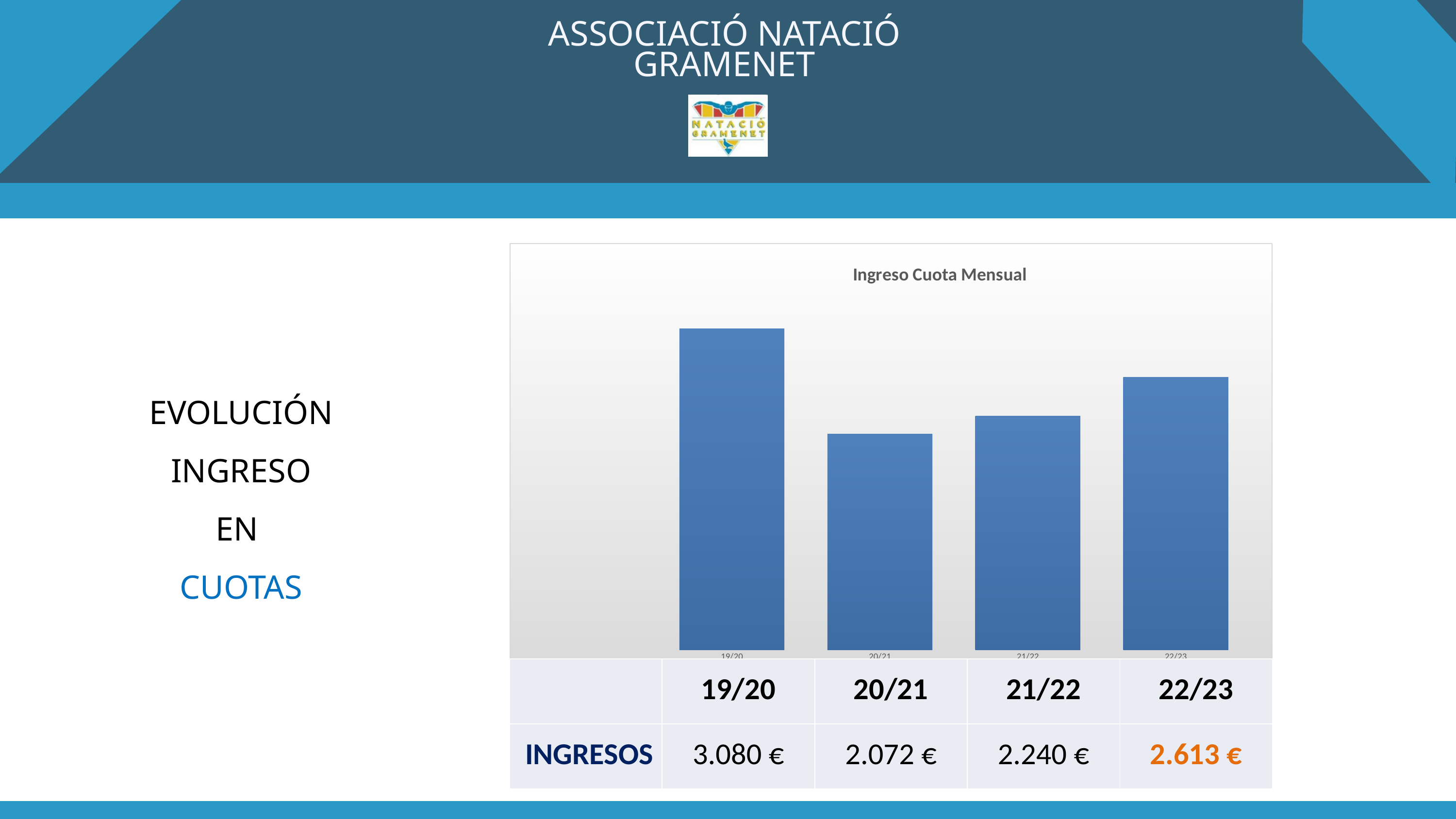
Which season has the lowest value? 20/21 What is the title of the chart? Ingreso Cuota Mensual What is the value for 21/22? 2.240 € What is the difference between the values for 19/20 and 20/21? 1.008 € What is the value for 20/21? 2.072 € How many seasons (bars) does the chart show? 4 Which season has the highest value? 19/20 What kind of chart is shown on the slide? bar chart What is the value for 22/23? 2.613 € Do the values rise or fall from 20/21 to 22/23? rise Which is larger, the value for 22/23 or the value for 21/22? 22/23 What is the value for 19/20? 3.080 €